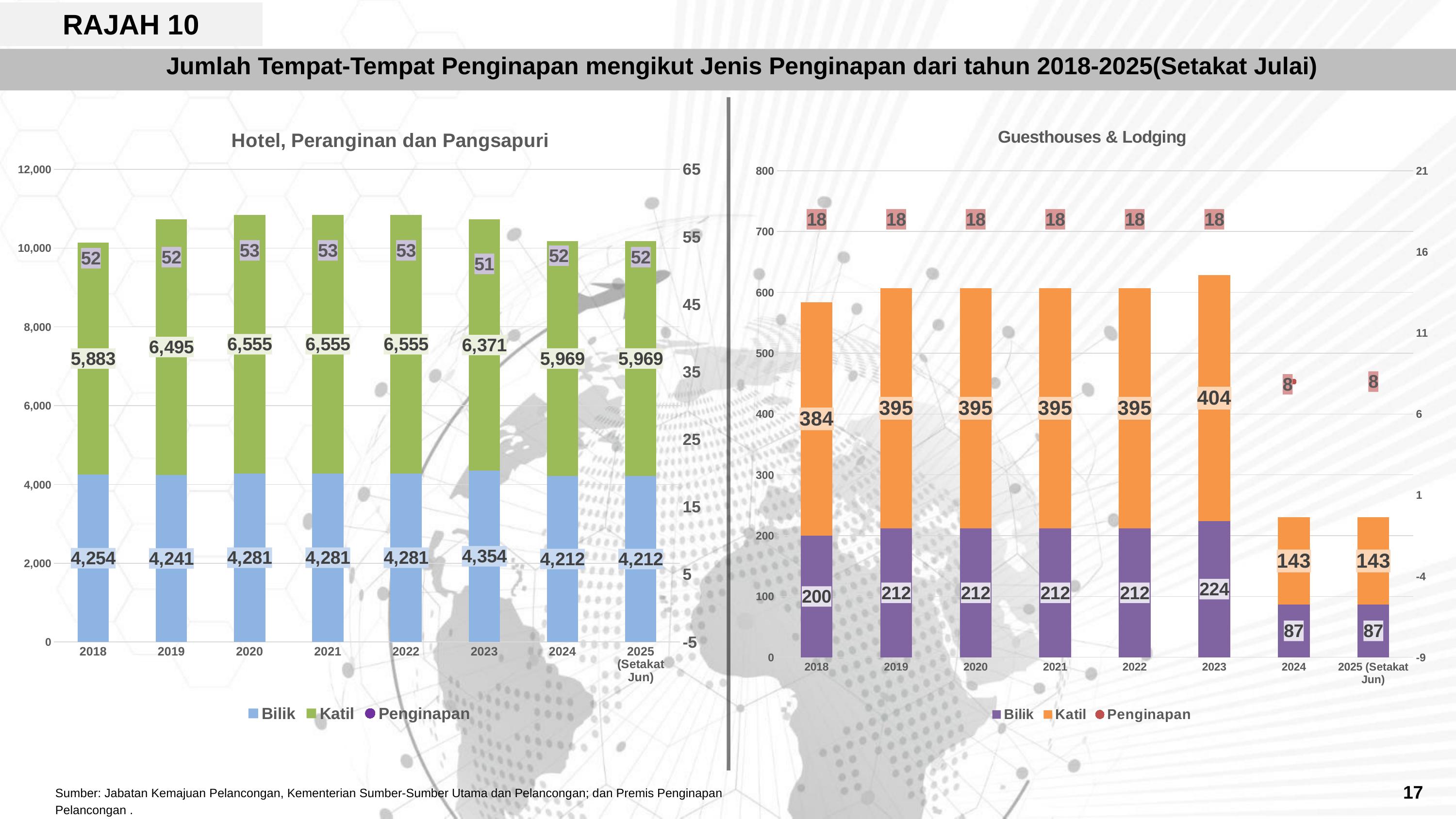
In the 'Hotel, Peranginan dan Pangsapuri' chart, which year has the highest Bilik value? 2023 In the 'Hotel, Peranginan dan Pangsapuri' chart, what is the total of Bilik and Katil for 2018? 10,137 In the 'Guesthouses & Lodging' chart, what is the total of Bilik and Katil for 2018? 584 In the 'Guesthouses & Lodging' chart, what is the Penginapan value for 2025 (Setakat Jun)? 8 In the 'Guesthouses & Lodging' chart, what is the Katil value for 2023? 404 In the 'Hotel, Peranginan dan Pangsapuri' chart, what is the Bilik value for 2023? 4,354 How many series does the legend of the 'Guesthouses & Lodging' chart list? 3 In the 'Hotel, Peranginan dan Pangsapuri' chart, what is the Katil value for 2019? 6,495 In the 'Hotel, Peranginan dan Pangsapuri' chart, what is the difference between the Katil values for 2020 and 2024? 586 In the 'Hotel, Peranginan dan Pangsapuri' chart, what is the Penginapan value for 2023? 51 In the 'Guesthouses & Lodging' chart, which year has the lowest Katil value? 2024 and 2025 (Setakat Jun) In the 'Guesthouses & Lodging' chart, what is the Bilik value for 2024? 87